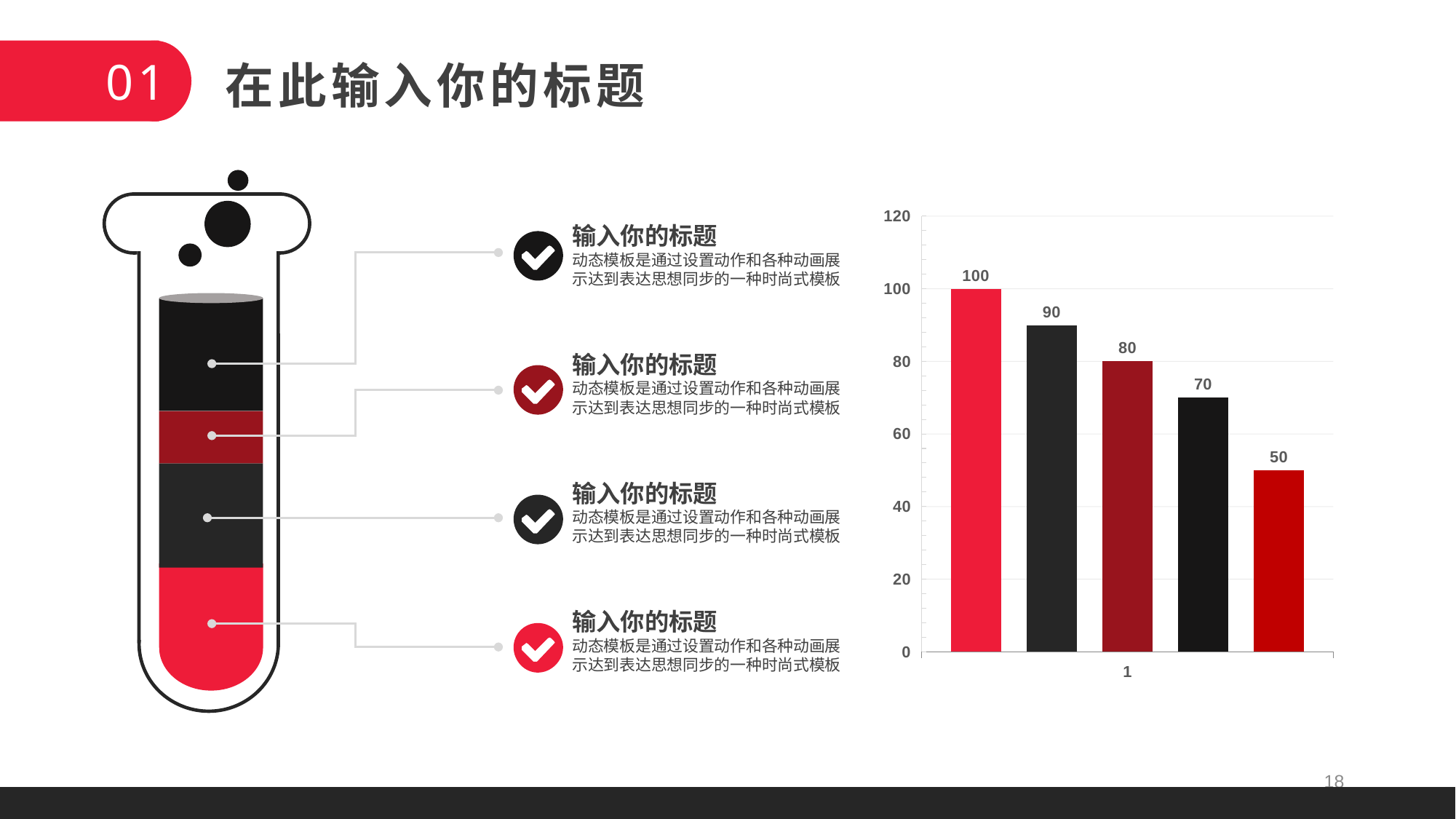
What is the value of the third bar from the left in the chart? 80 What is the highest tick value shown on the vertical axis of the chart? 120 What is the value of the rightmost bar in the chart? 50 How many bars are plotted in the chart? 5 Which is larger, the second bar or the fourth bar? the second bar (90) What type of chart is shown on the slide? bar chart What is the value of the first (leftmost) bar in the chart? 100 Do the bar values rise or fall from left to right? fall What is the difference between the first bar (100) and the last bar (50)? 50 What is the lowest value shown in the chart? 50 What is the difference between the second bar (90) and the fourth bar (70)? 20 What is the highest value shown in the chart? 100